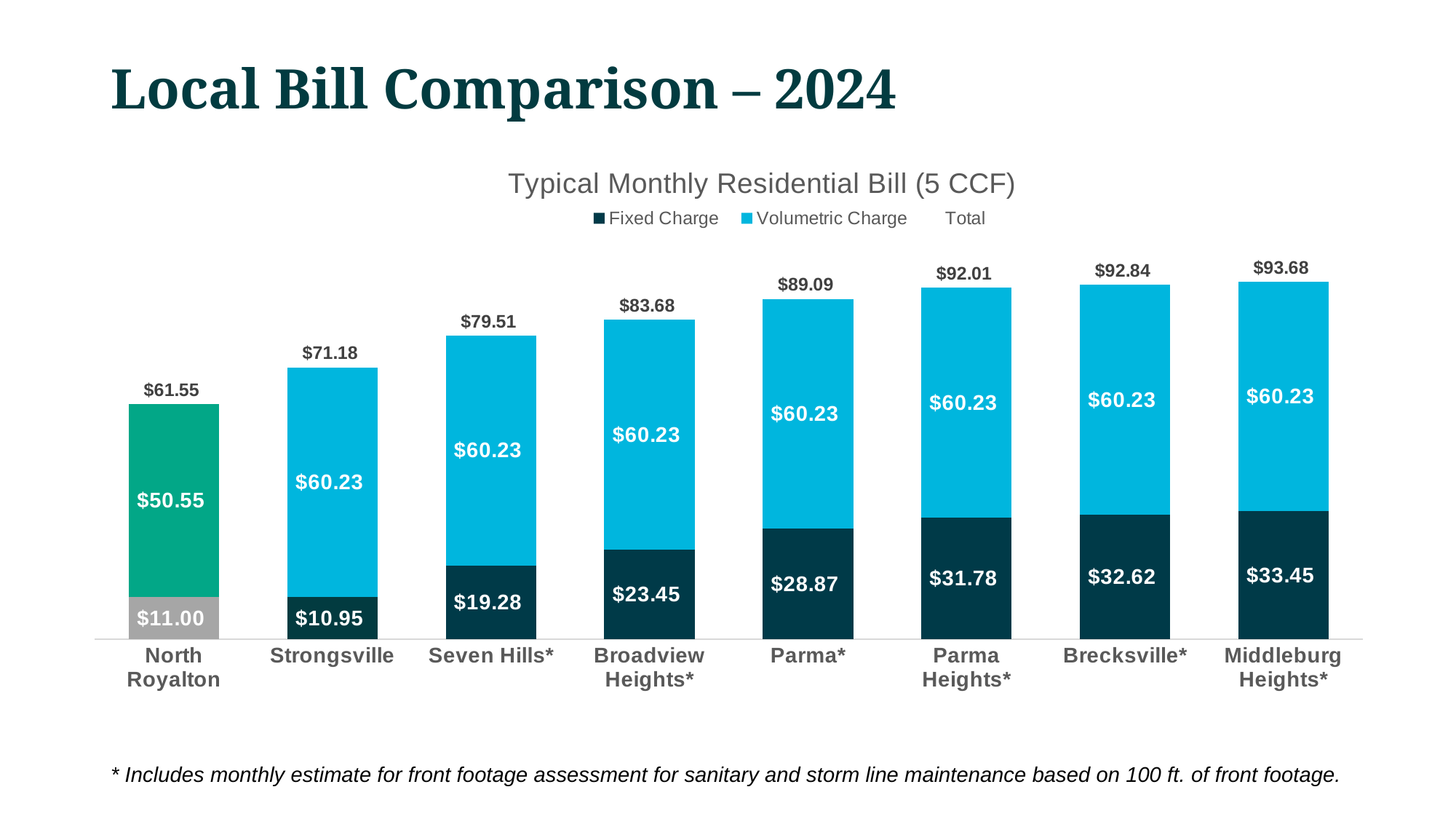
What kind of chart is shown on the slide? Stacked bar chart Which is larger, the Fixed Charge for Parma* or the Fixed Charge for Broadview Heights*? Parma* What is the difference between the total bills for Middleburg Heights* and North Royalton? $32.13 What is the title of the chart? Typical Monthly Residential Bill (5 CCF) How many communities are shown on the x axis? 8 Which community has the lowest Fixed Charge? Strongsville Do the total bills rise or fall moving from left to right across the x axis? Rise Which community has the highest total monthly bill? Middleburg Heights* What is the Fixed Charge for Seven Hills*? $19.28 How many series does the legend list? 3 What is the total typical monthly residential bill for North Royalton? $61.55 What is the Volumetric Charge for Strongsville? $60.23